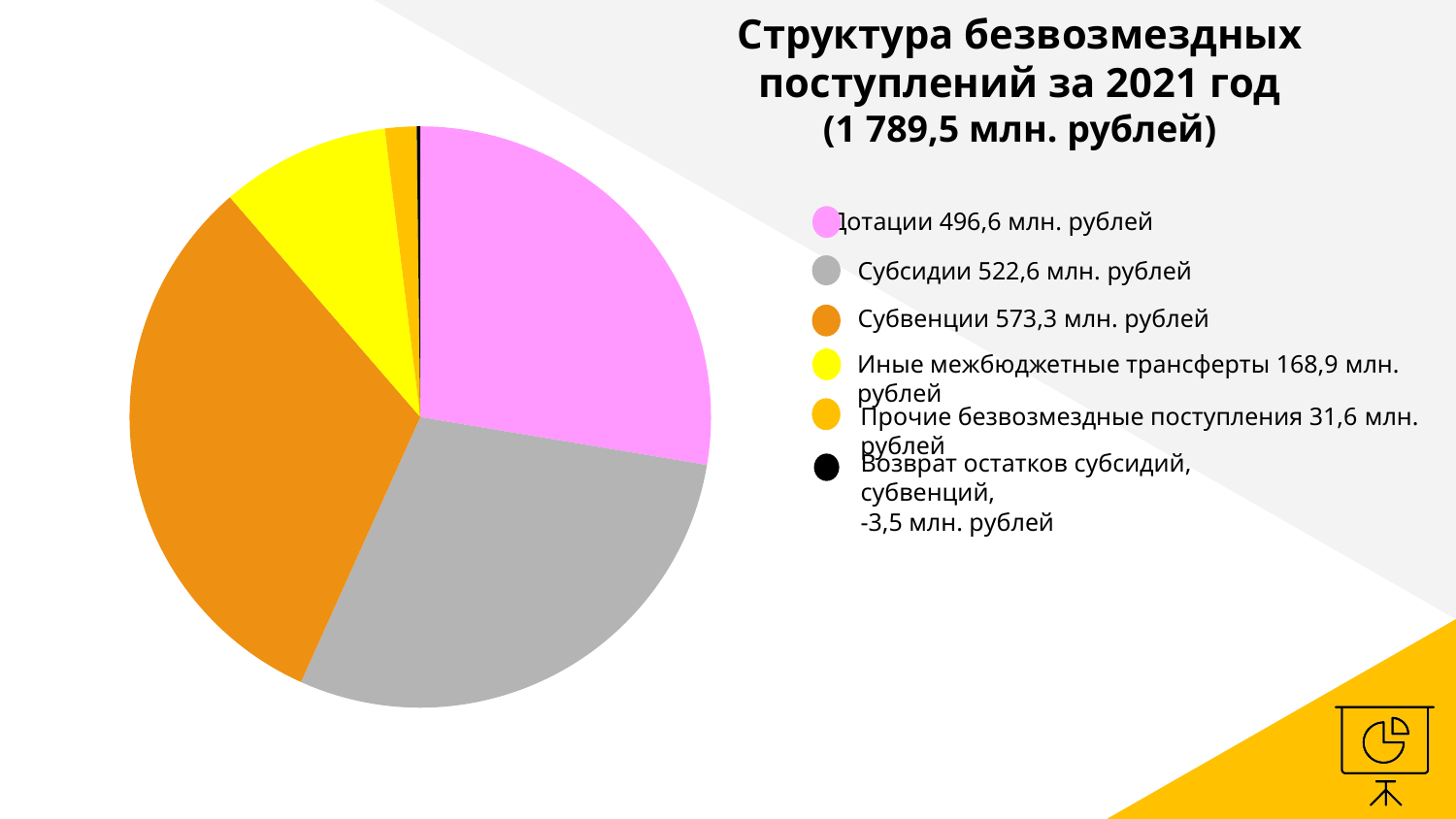
Which category has the largest value? Субвенции What is the difference between Субвенции and Субсидии? 50,7 млн. рублей What total amount is given in the chart title? 1 789,5 млн. рублей What is the value for Дотации? 496,6 млн. рублей What is the value for Возврат остатков субсидий, субвенций? -3,5 млн. рублей How many categories does the legend list? 6 What kind of chart is shown on the slide? Pie chart What colour represents Субвенции in the pie chart? Orange What is the value for Субсидии? 522,6 млн. рублей Which category has the smallest value? Возврат остатков субсидий, субвенций What is the value for Иные межбюджетные трансферты? 168,9 млн. рублей Which is larger, Субсидии or Дотации? Субсидии